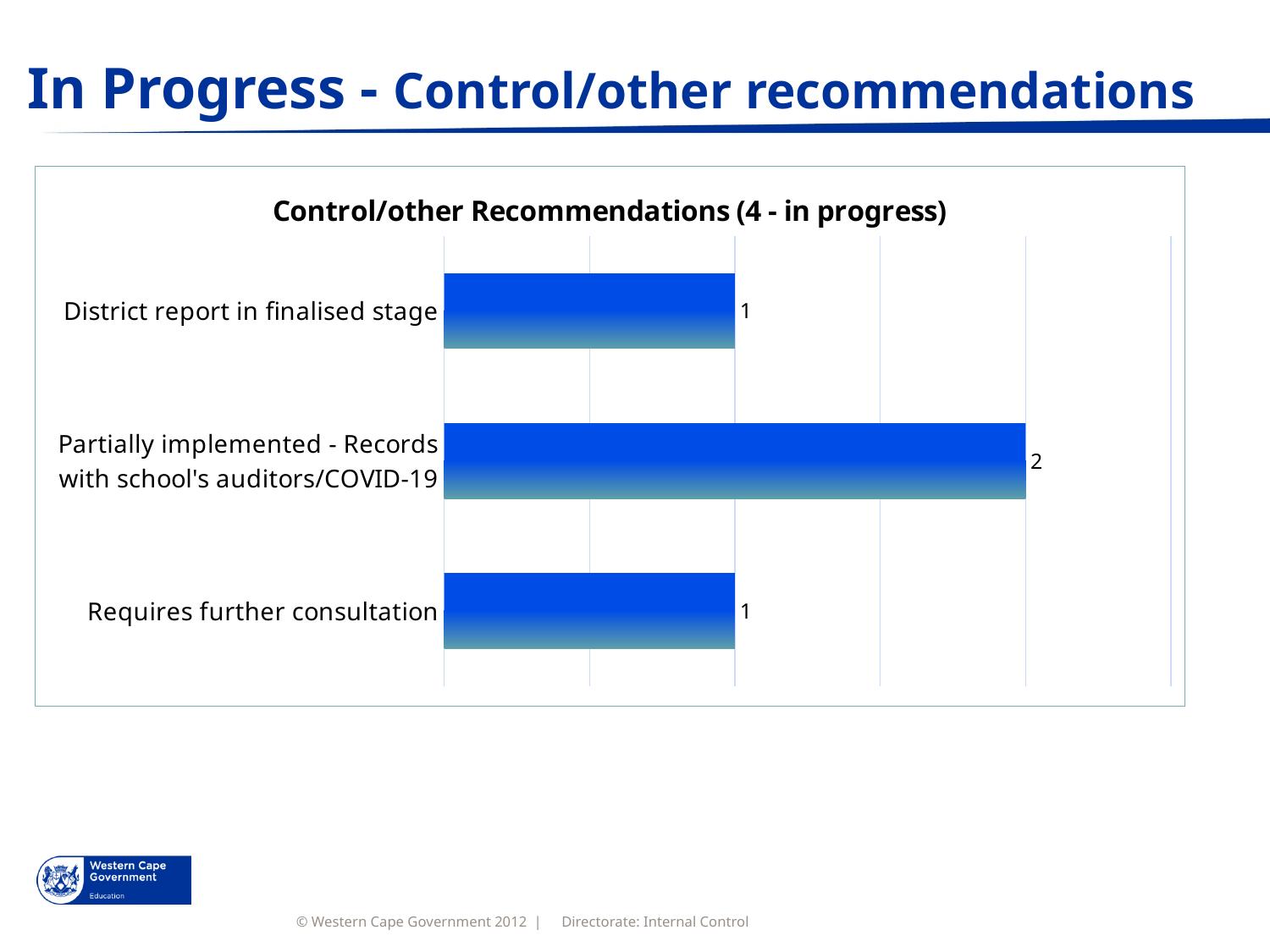
What is the total of all the values shown in the chart? 4 How many categories are shown in the chart? 3 Which category has the highest value? Partially implemented - Records with school's auditors/COVID-19 What is the difference between the value for 'Partially implemented - Records with school's auditors/COVID-19' and the value for 'Requires further consultation'? 1 What is the value for 'District report in finalised stage'? 1 What kind of chart is shown on the slide? Bar chart What is the value for 'Partially implemented - Records with school's auditors/COVID-19'? 2 What is the value for 'Requires further consultation'? 1 Are the bars in the chart horizontal or vertical? Horizontal Which is larger: the value for 'Partially implemented - Records with school's auditors/COVID-19' or the value for 'District report in finalised stage'? Partially implemented - Records with school's auditors/COVID-19 What is the title of the chart? Control/other Recommendations (4 - in progress)